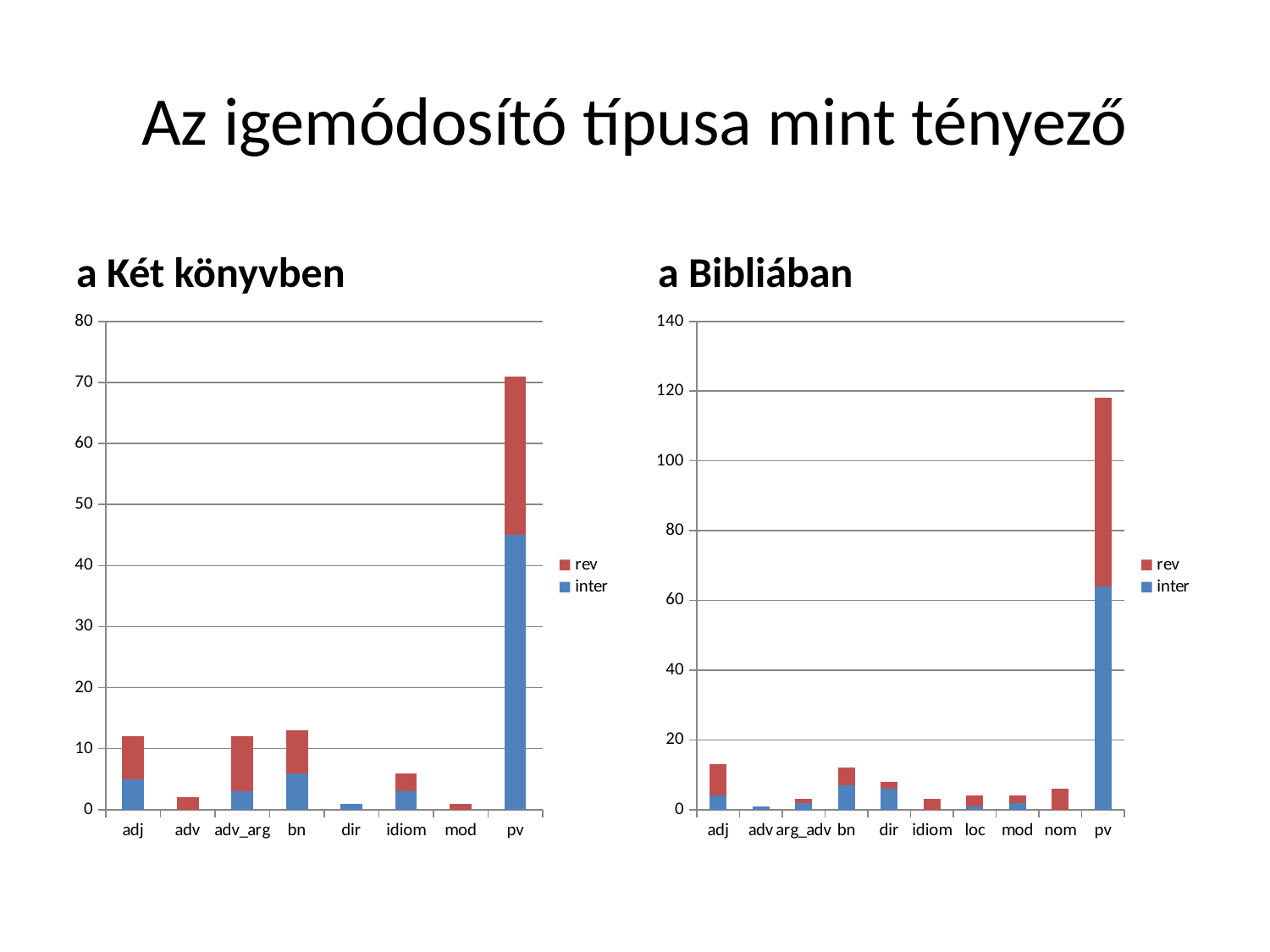
In the chart titled "a Két könyvben", is the total value for pv greater or less than 60? greater How many categories are shown on the x axis of the chart titled "a Bibliában"? 10 How many categories are shown on the x axis of the chart titled "a Két könyvben"? 8 In the chart titled "a Két könyvben", which category has the highest total? pv What kind of chart is the chart titled "a Két könyvben"? stacked bar chart In the chart titled "a Bibliában", is the total value for pv greater or less than 100? greater In the chart titled "a Két könyvben", is the total value for dir greater or less than 10? less In the chart titled "a Bibliában", which category has the lowest total? adv How many series does the legend of the chart titled "a Bibliában" list? 2 What are the two series named in the legend of the chart titled "a Két könyvben"? rev and inter In the chart titled "a Bibliában", which category has the highest total? pv In the chart titled "a Bibliában", which has the larger total, bn or dir? bn